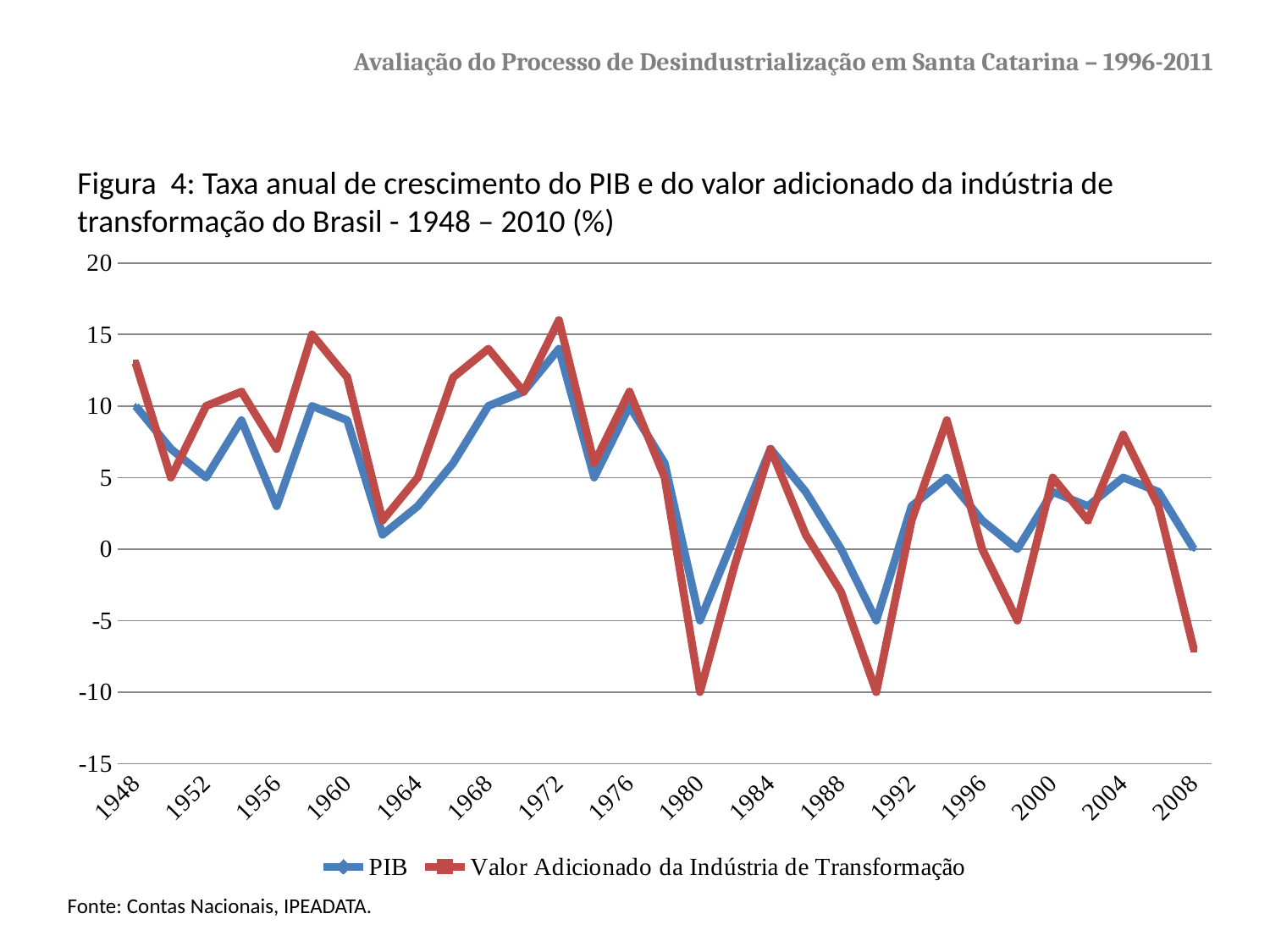
Is the highest value reached by the Valor Adicionado da Indústria de Transformação line greater or less than 15? greater Is the lowest value reached by the Valor Adicionado da Indústria de Transformação line greater or less than -5? less Overall, do the growth rates tend to rise or fall from 1948 to 2008? fall What colour is the PIB line? blue How many year labels are shown on the x axis? 16 What kind of chart is shown on the slide? line chart What are the two series named in the legend? PIB; Valor Adicionado da Indústria de Transformação Is the lowest value reached by the PIB line greater or less than -10? greater Which series reaches the highest peak on the chart? Valor Adicionado da Indústria de Transformação In 1948, which series has the higher value, PIB or Valor Adicionado da Indústria de Transformação? Valor Adicionado da Indústria de Transformação Which series reaches the lowest value on the chart? Valor Adicionado da Indústria de Transformação How many series does the legend list? 2